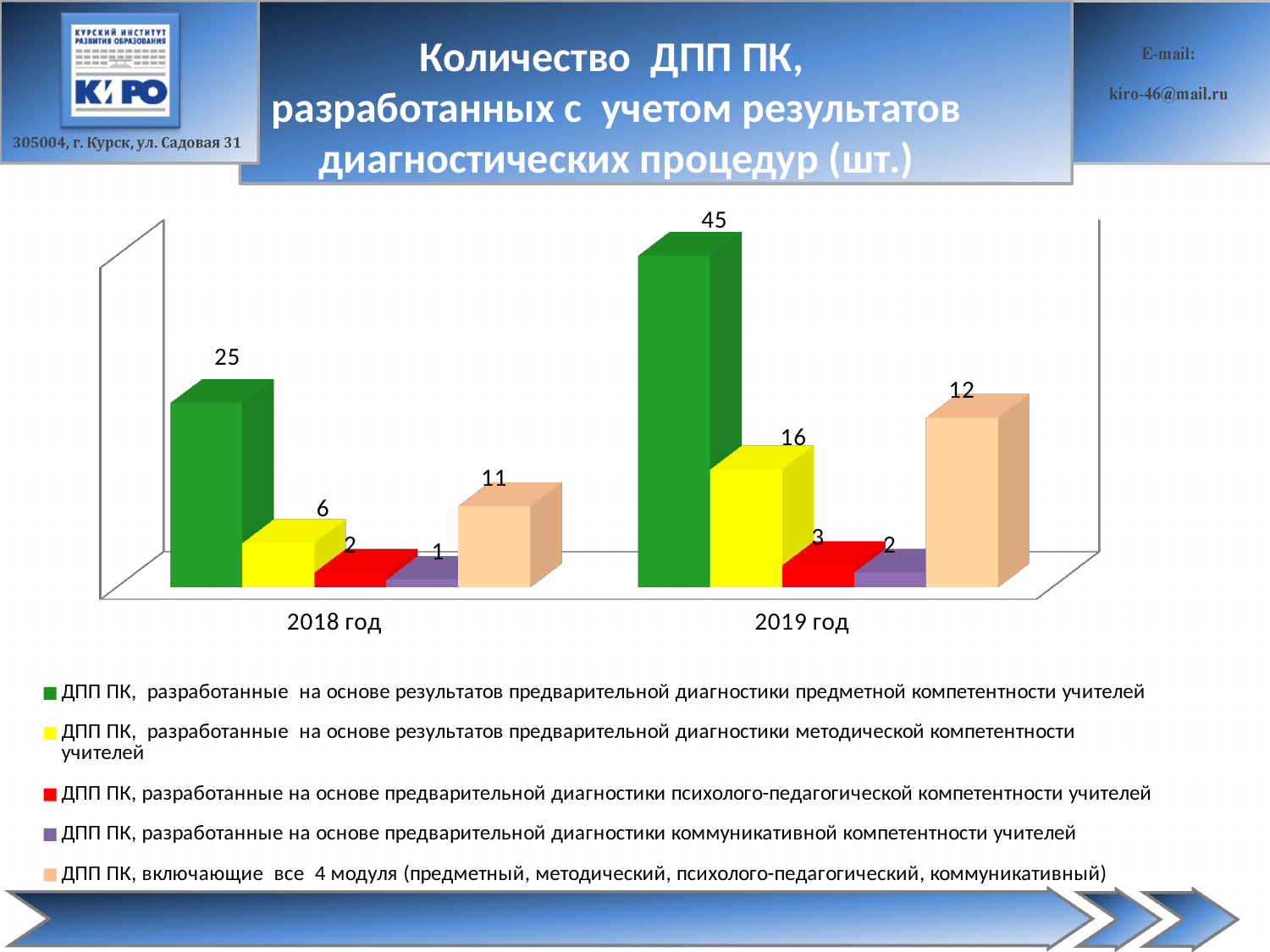
By how much did the green series (предметной компетентности учителей) increase from 2018 год to 2019 год? 20 Which series has the highest value in 2019 год? ДПП ПК, разработанные на основе результатов предварительной диагностики предметной компетентности учителей Which series has the lowest value in 2018 год? ДПП ПК, разработанные на основе предварительной диагностики коммуникативной компетентности учителей What is the value of the green series (предметной компетентности учителей) for 2019 год? 45 Which is larger in 2018 год: the yellow series (методической компетентности) or the light orange series (все 4 модуля)? ДПП ПК, включающие все 4 модуля What is the value of the green series (ДПП ПК, разработанные на основе результатов предварительной диагностики предметной компетентности учителей) for 2018 год? 25 What is the difference between the yellow series (методической компетентности) and the red series (психолого-педагогической компетентности) in 2019 год? 13 What kind of chart is shown on the slide? Bar chart What is the value of the light orange series (ДПП ПК, включающие все 4 модуля) for 2018 год? 11 How many series does the legend list? 5 What is the value of the yellow series (методической компетентности учителей) for 2019 год? 16 What is the value of the purple series (коммуникативной компетентности учителей) for 2019 год? 2